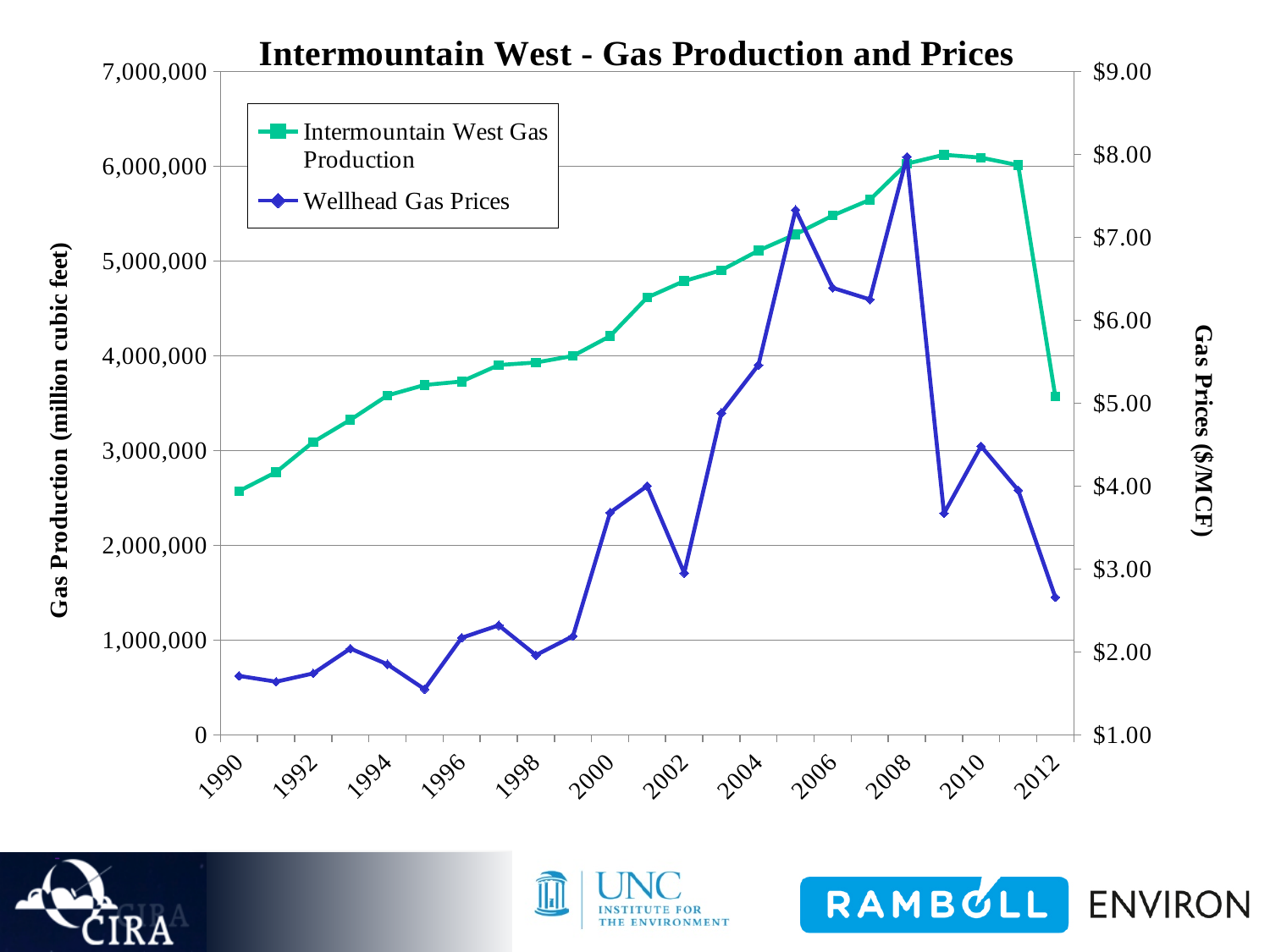
What kind of chart is shown on the slide? line chart In which year is Intermountain West Gas Production lowest? 1990 In which year is the Wellhead Gas Prices value lowest? 1995 Is the Intermountain West Gas Production value for 1990 greater or less than 3,000,000? less What is the label of the right-hand vertical axis? Gas Prices ($/MCF) How many series does the legend list? 2 In which year is the Wellhead Gas Prices value highest? 2008 How many yearly data points does each series have? 23 Does Intermountain West Gas Production rise or fall from 1990 to 2008? rise Is the Wellhead Gas Prices value for 2012 greater or less than $3.00? less Which is larger, Intermountain West Gas Production in 2012 or in 1990? 2012 What is the title of the chart? Intermountain West - Gas Production and Prices